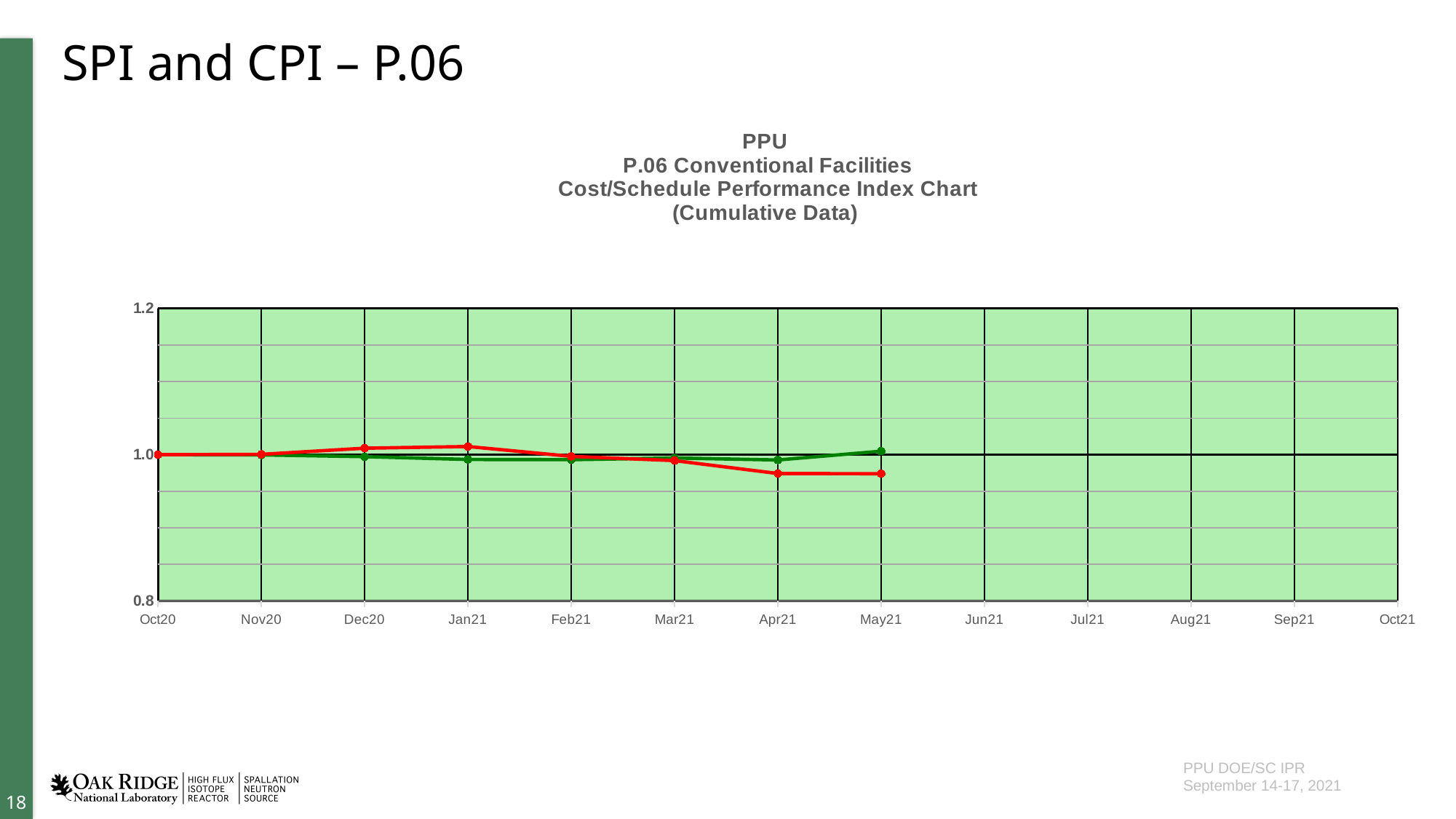
Is the value of the red line at Apr21 greater or less than 1.0? less Is the value of the red line at May21 greater or less than 1.0? less What is the last month for which data points are plotted on the chart? May21 How many month labels are shown along the x axis of the chart? 13 At Apr21, which line has the higher value, the red line or the green line? Green line How many lines are plotted on the chart? 2 What kind of chart is shown on the slide? Line chart Does the red line rise or fall from Jan21 to Apr21? Fall At which month does the red line reach its highest value? Jan21 Is the value of the red line at Jan21 greater or less than 1.0? greater At Jan21, which line has the higher value, the red line or the green line? Red line What is the highest value shown on the y axis of the chart? 1.2